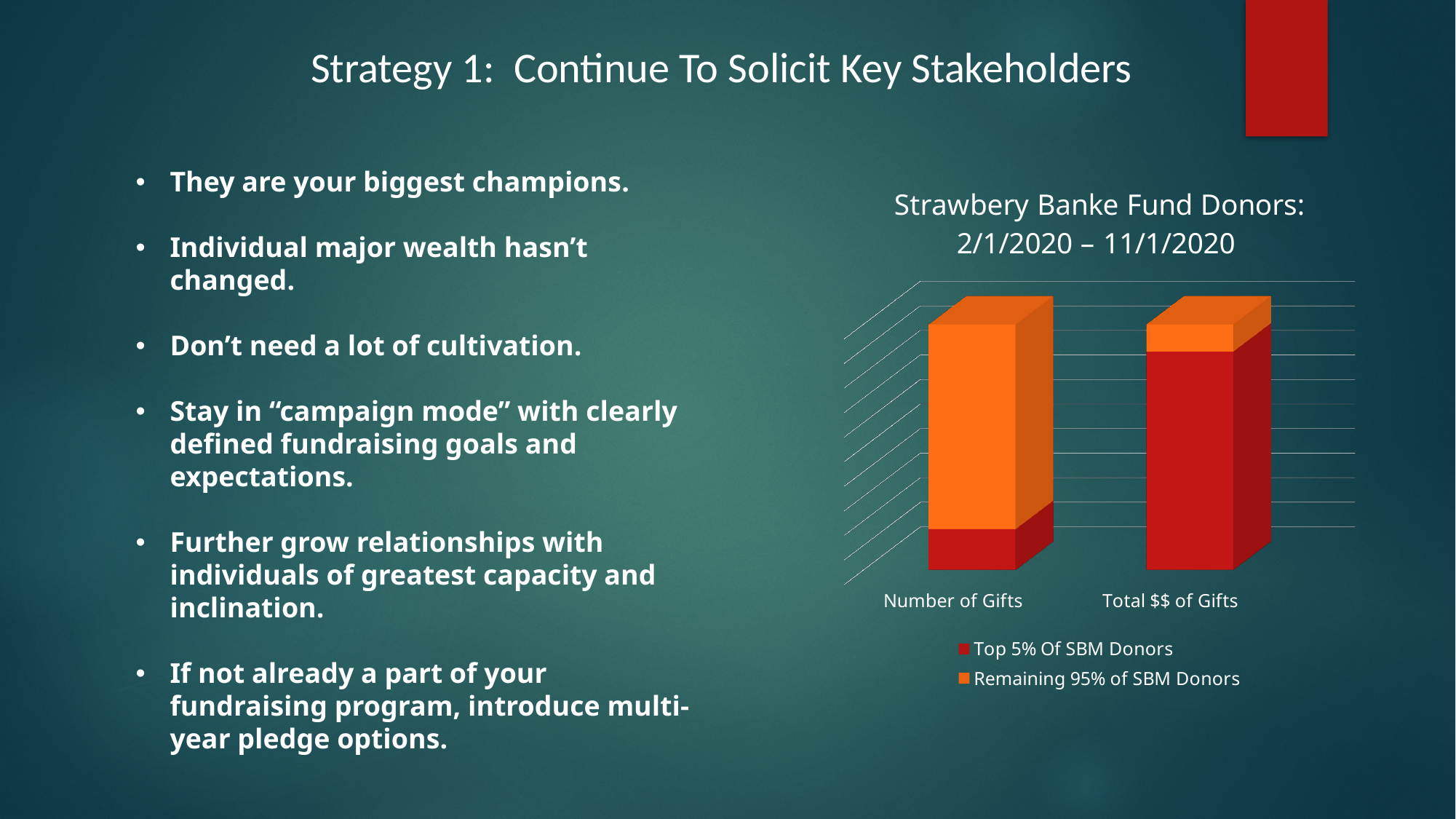
What are the two category labels on the x axis of the chart? Number of Gifts; Total $$ of Gifts Is the Remaining 95% of SBM Donors segment larger for Number of Gifts or for Total $$ of Gifts? Number of Gifts What is the title of the chart? Strawbery Banke Fund Donors: 2/1/2020 – 11/1/2020 In the Number of Gifts bar, which series makes up the larger portion: Top 5% Of SBM Donors or Remaining 95% of SBM Donors? Remaining 95% of SBM Donors For which category is the Remaining 95% of SBM Donors segment largest? Number of Gifts In the Total $$ of Gifts bar, which series makes up the larger portion: Top 5% Of SBM Donors or Remaining 95% of SBM Donors? Top 5% Of SBM Donors How many series does the chart legend list? 2 For which category is the Top 5% Of SBM Donors segment largest? Total $$ of Gifts Which series is shown in orange in the chart? Remaining 95% of SBM Donors For which category is the Top 5% Of SBM Donors segment smallest? Number of Gifts How many categories are shown on the x axis of the chart? 2 What kind of chart is shown on the slide? Stacked bar chart